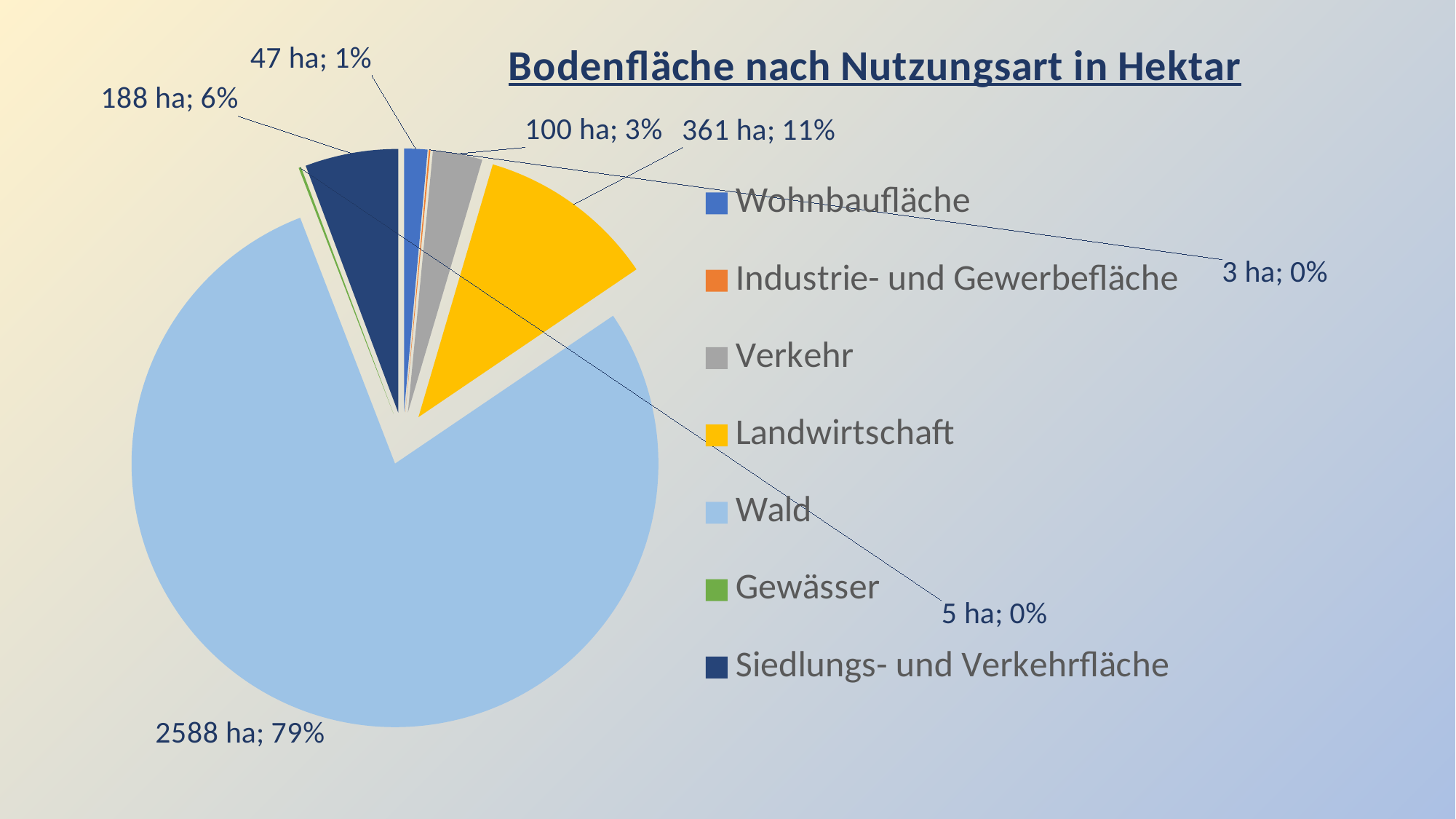
What is the value for Wohnbaufläche? 47 ha; 1% What share of the pie does Wald represent? 79% What is the value for Wald? 2588 ha; 79% How many categories does the legend list? 7 What kind of chart is shown? Pie chart What is the value for Siedlungs- und Verkehrfläche? 188 ha; 6% What is the value for Verkehr? 100 ha; 3% Which is larger, Verkehr or Wohnbaufläche? Verkehr What is the value for Landwirtschaft? 361 ha; 11% Which category has the smallest slice? Industrie- und Gewerbefläche Which category has the largest slice? Wald What is the difference in hectares between Landwirtschaft and Siedlungs- und Verkehrfläche? 173 ha